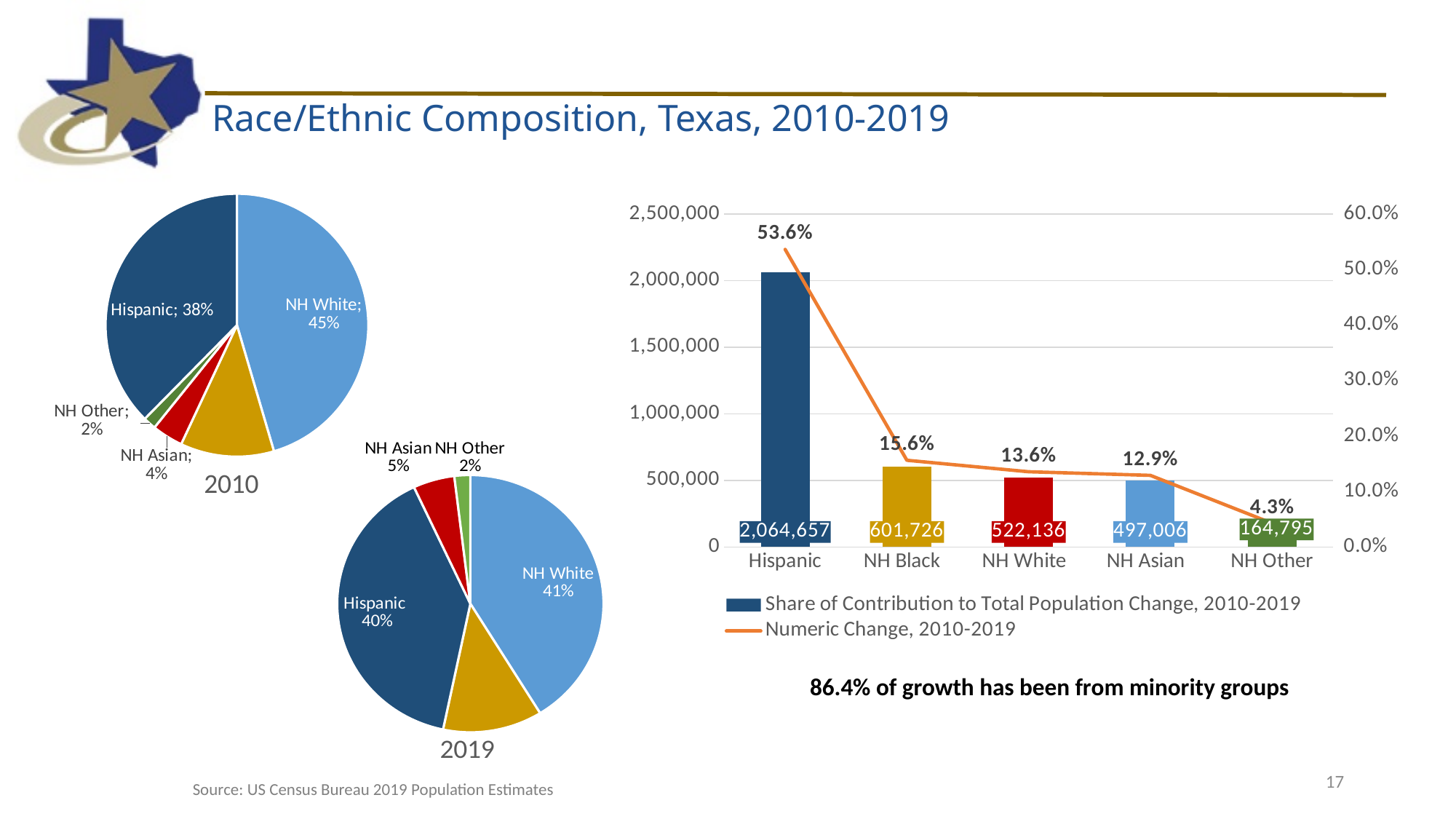
In the 2019 pie chart, what share is labeled for NH Other? 2% In the bar chart on the right, what is the difference in numeric change between NH White and NH Asian? 25,130 In the bar chart on the right, what is the share of contribution to total population change for NH Black? 15.6% In the 2019 pie chart, what share is labeled for NH Asian? 5% In the 2010 pie chart, what share is labeled for Hispanic? 38% In the bar chart on the right, what is the numeric change for NH Other? 164,795 How many series does the legend of the chart on the right list? 2 In the bar chart on the right, which category has the lowest numeric change? NH Other How many categories are shown on the x axis of the bar chart on the right? 5 In the 2010 pie chart, what share is labeled for NH White? 45% In the 2019 pie chart, which is larger, the NH White slice or the Hispanic slice? NH White In the bar chart on the right, what is the numeric change for Hispanic? 2,064,657